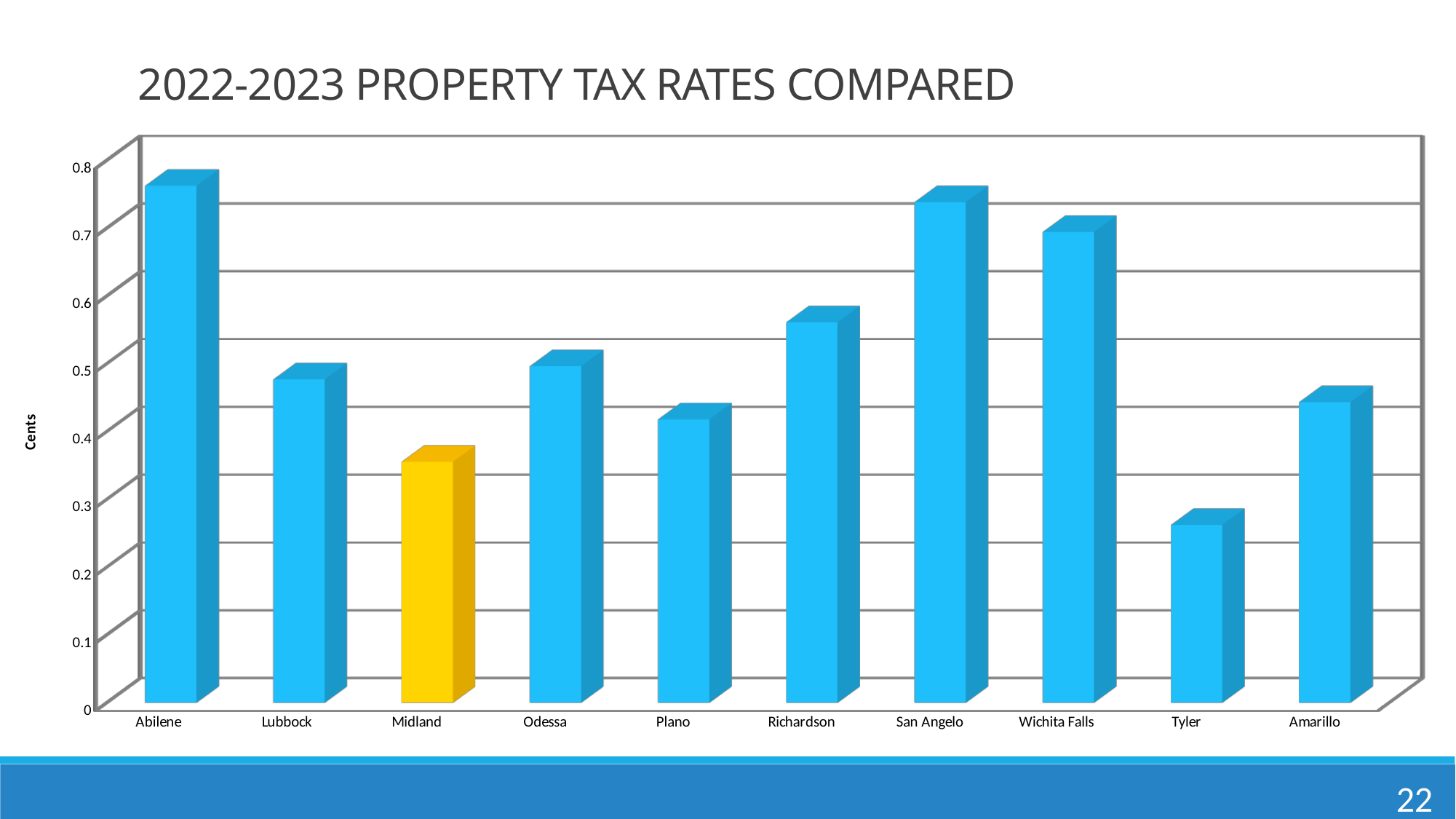
Which city's bar is shown in yellow instead of blue? Midland What kind of chart is shown on the slide? bar chart Is the value for Abilene greater or less than 0.7? greater Which has a higher property tax rate, Midland or Tyler? Midland Is the value for Richardson greater or less than 0.5? greater Is the value for Tyler greater or less than 0.3? less Which city has the highest property tax rate in the chart? Abilene How many cities are shown on the x axis of the chart? 10 Which has a higher property tax rate, Richardson or Plano? Richardson Which city has the lowest property tax rate in the chart? Tyler